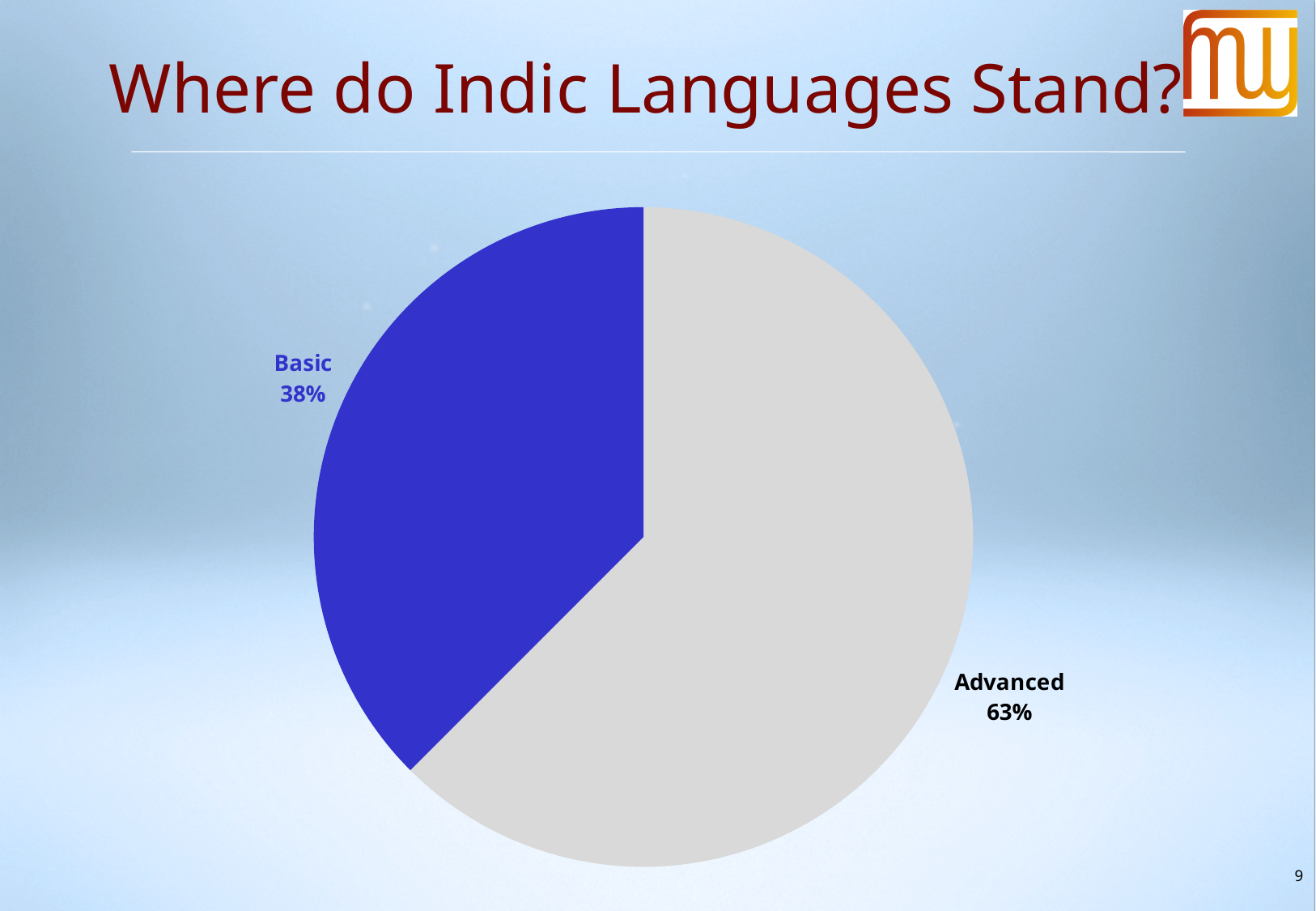
What share of the pie does the Basic slice represent? 38% Which slice of the pie is the largest? Advanced Which slice of the pie is the smallest? Basic What kind of chart is shown on the slide? pie chart Which is larger, the Basic slice or the Advanced slice? Advanced What share of the pie does the Advanced slice represent? 63% What is the title of the slide containing the pie chart? Where do Indic Languages Stand? What is the difference in percentage points between the Advanced and Basic slices? 25 What colour is the Basic slice of the pie? blue How many slices does the pie chart have? 2